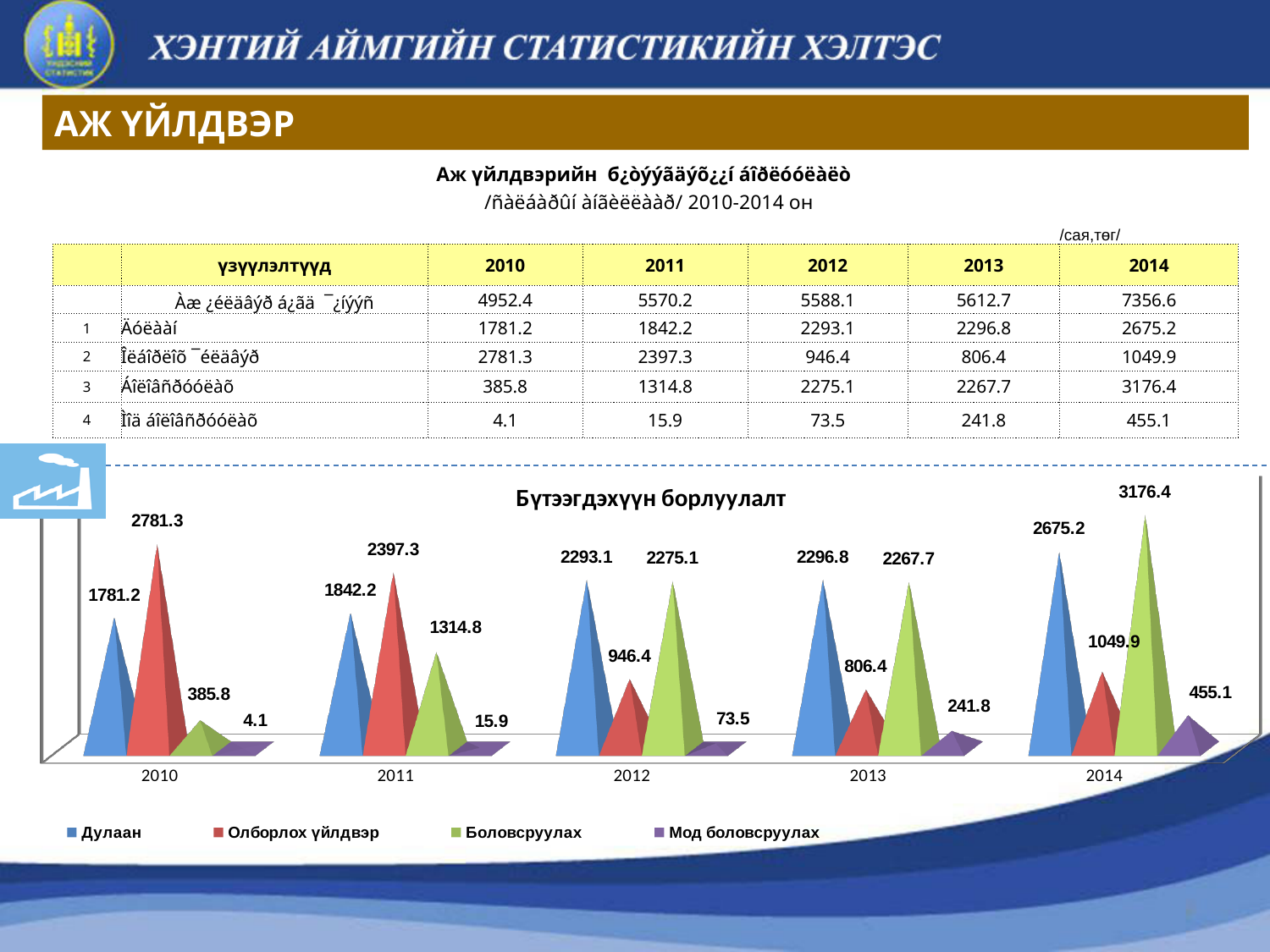
What is the value for Олборлох үйлдвэр in 2010? 2781.3 In which year is the value for Боловсруулах highest? 2014 What is the title of the chart? Бүтээгдэхүүн борлуулалт Does the value for Мод боловсруулах rise or fall from 2010 to 2014? rise What is the value for Мод боловсруулах in 2013? 241.8 How many series does the chart legend list? 4 How many years are shown on the x axis of the chart? 5 In which year is the value for Мод боловсруулах lowest? 2010 Which is larger in 2014: Дулаан or Боловсруулах? Боловсруулах What is the difference between the Олборлох үйлдвэр values in 2010 and 2011? 384 What is the value for Дулаан in 2014? 2675.2 What is the value for Боловсруулах in 2012? 2275.1